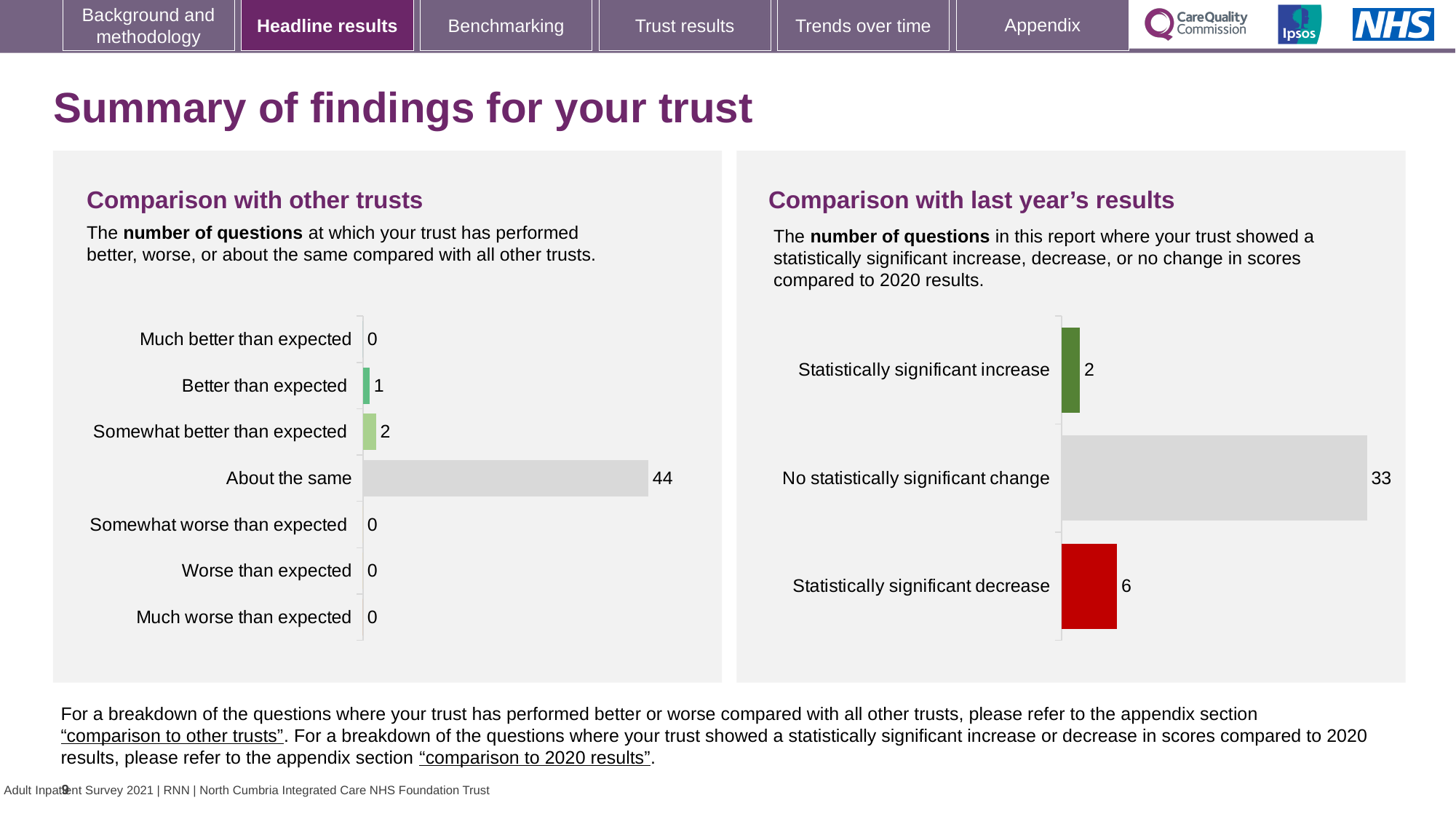
In the 'Comparison with other trusts' chart, which category has the highest value? About the same In the 'Comparison with last year's results' chart, what is the difference between 'No statistically significant change' and 'Statistically significant decrease'? 27 In the 'Comparison with other trusts' chart, how many questions are 'Better than expected'? 1 In the 'Comparison with other trusts' chart, how many questions are 'About the same'? 44 In the 'Comparison with last year's results' chart, how many questions showed a statistically significant decrease? 6 In the 'Comparison with other trusts' chart, how many categories are shown? 7 In the 'Comparison with last year's results' chart, which is larger: statistically significant increase or statistically significant decrease? Statistically significant decrease What type of chart is used in the 'Comparison with last year's results' panel? Bar chart In the 'Comparison with other trusts' chart, what is the difference between 'About the same' and 'Somewhat better than expected'? 42 In the 'Comparison with last year's results' chart, how many questions showed no statistically significant change? 33 In the 'Comparison with other trusts' chart, how many questions are 'Somewhat better than expected'? 2 In the 'Comparison with last year's results' chart, how many questions showed a statistically significant increase? 2